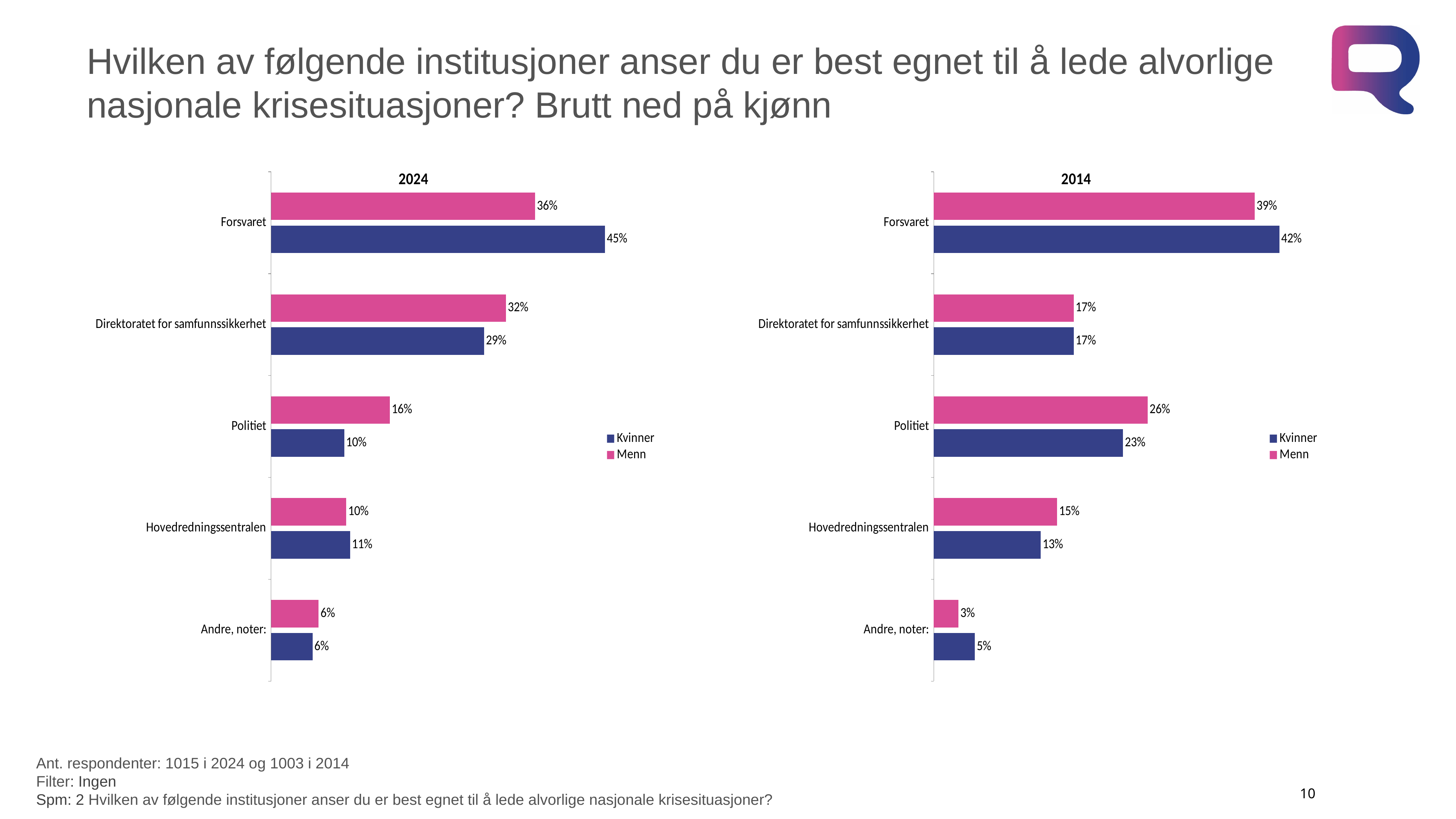
In the 2024 chart, what is the value for Kvinner for Forsvaret? 45% In the 2024 chart, which is larger for Politiet: the Kvinner value or the Menn value? Menn In the 2024 chart, what is the difference between the Kvinner and Menn values for Forsvaret? 9% In the 2024 chart, which category has the highest value for Menn? Forsvaret In the 2014 chart, what is the difference between the Menn and Kvinner values for Politiet? 3% In the 2014 chart, which category has the lowest value for Kvinner? Andre, noter: How many series does the legend of the 2024 chart list? 2 How many categories does the 2014 chart show? 5 In the 2024 chart, what is the value for Menn for Direktoratet for samfunnssikkerhet? 32% In the 2014 chart, what is the value for Kvinner for Hovedredningssentralen? 13% In the 2014 chart, what is the value for Menn for Politiet? 26% What kind of chart is the 2014 chart? Bar chart